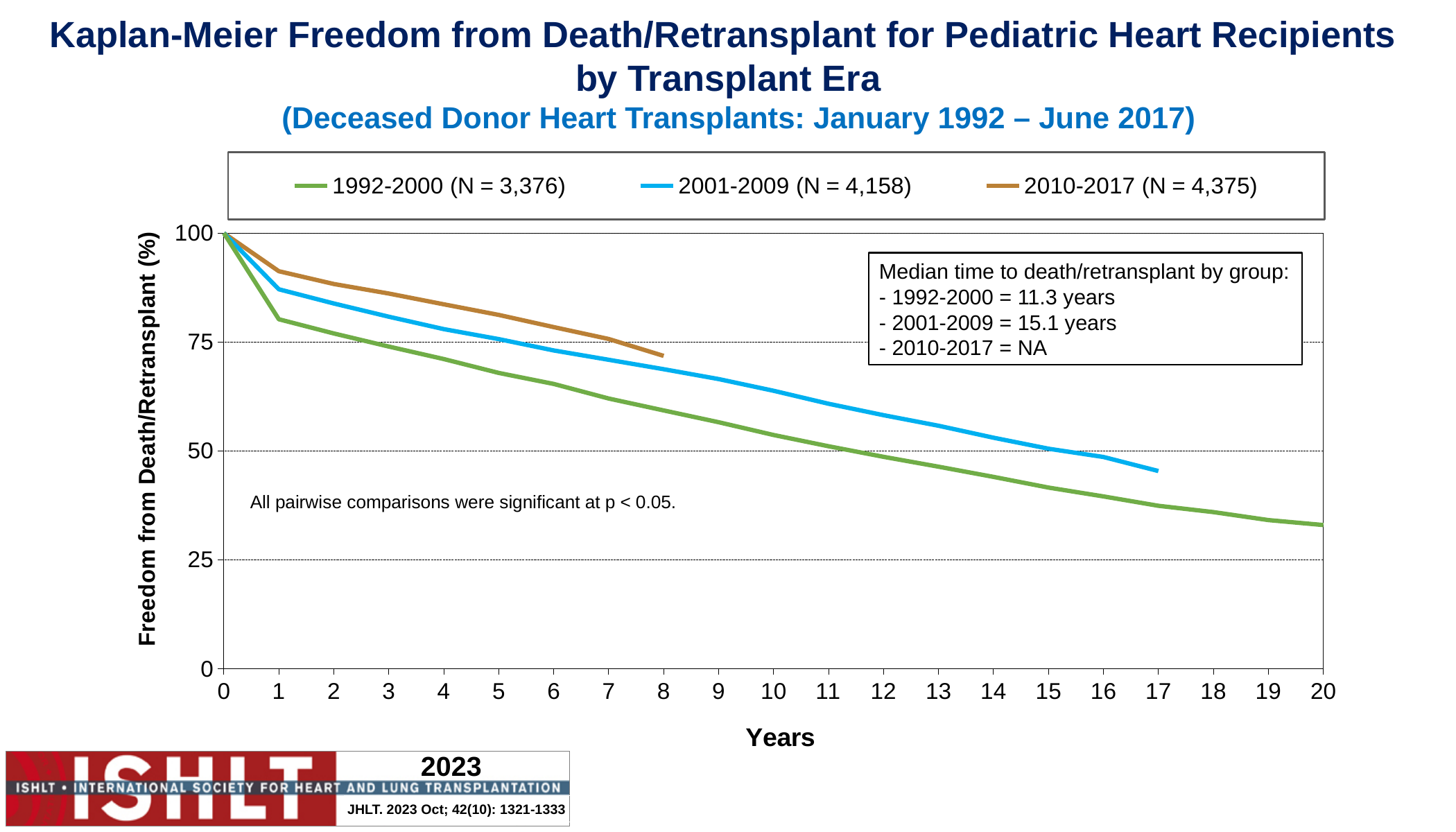
What is the sample size (N) for the 2001-2009 era in the legend? 4,158 What kind of chart is shown on the slide? Line chart Do the freedom from death/retransplant curves rise or fall as years increase? Fall Is the value for the 2001-2009 series at 17 years greater or less than 50? less What is the median time to death/retransplant for the 1992-2000 group? 11.3 years How many series does the legend list? 3 What is the median time to death/retransplant for the 2001-2009 group? 15.1 years At 10 years, which series has the higher freedom from death/retransplant: 1992-2000 or 2001-2009? 2001-2009 At 5 years, which transplant era has the highest freedom from death/retransplant? 2010-2017 What is the median time to death/retransplant for the 2010-2017 group? NA Is the value for the 2010-2017 series at 5 years greater or less than 75? greater Is the value for the 1992-2000 series at 10 years greater or less than 50? greater